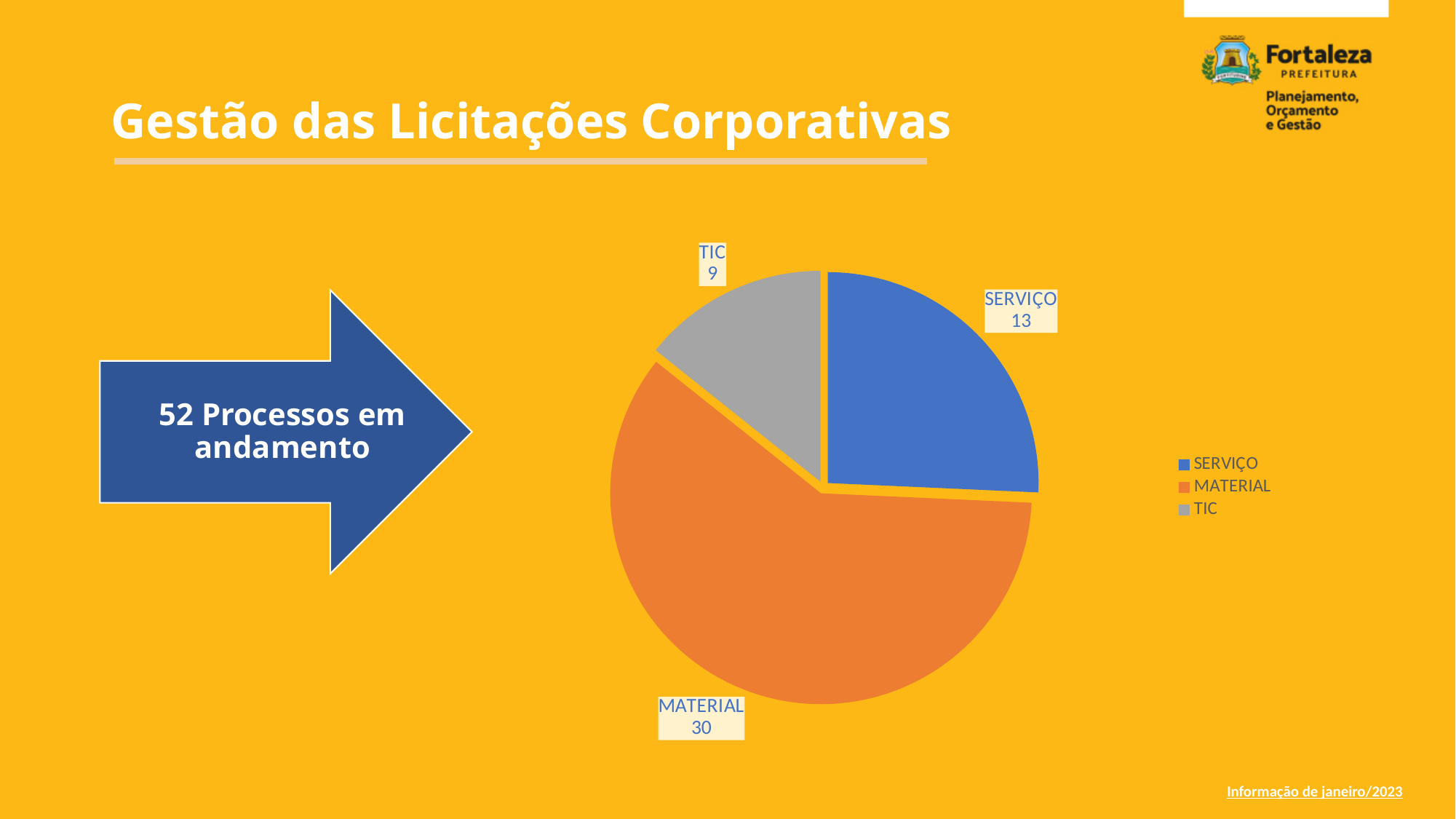
What type of chart is shown on the slide? Pie chart What is the value for SERVIÇO in the pie chart? 13 What is the value for TIC in the pie chart? 9 Which colour represents MATERIAL in the pie chart legend? Orange Which category has the largest slice in the pie chart? MATERIAL How many categories are shown in the pie chart? 3 Which category has the smallest slice in the pie chart? TIC What is the difference between the values for SERVIÇO and TIC? 4 What is the total of all slices in the pie chart? 52 What is the value for MATERIAL in the pie chart? 30 Which is larger, the value for SERVIÇO or the value for TIC? SERVIÇO What is the difference between the values for MATERIAL and SERVIÇO? 17